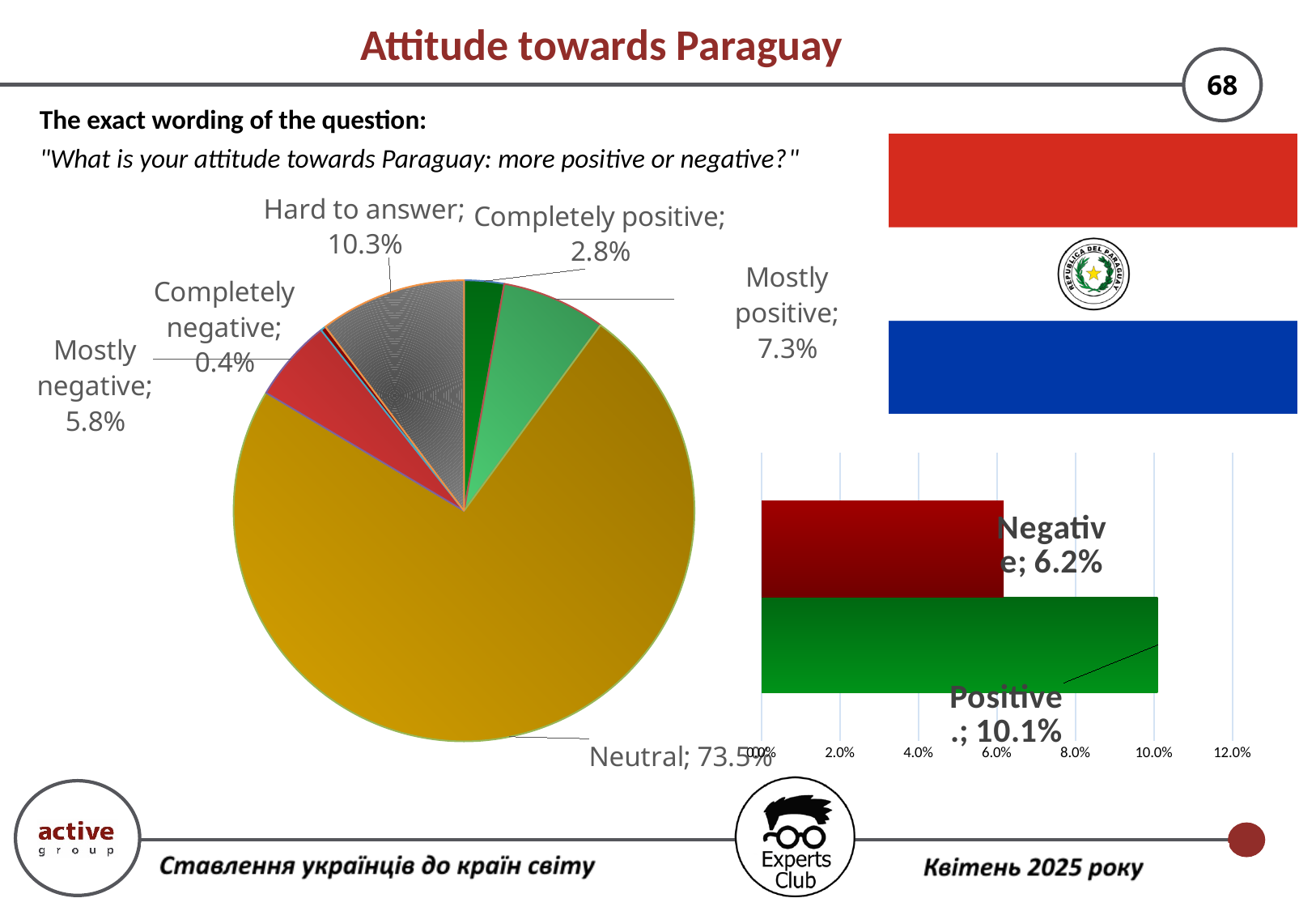
In the pie chart, which category has the largest slice? Neutral In the bar chart on the right, what is the difference between "Positive" and "Negative"? 3.9% In the pie chart, what is the difference between "Mostly positive" and "Completely positive"? 4.5% In the pie chart, which category has the smallest slice? Completely negative How many categories does the pie chart show? 6 In the pie chart, which is larger: "Mostly negative" or "Mostly positive"? Mostly positive What kind of chart is shown on the right side of the slide below the flag? Bar chart In the pie chart, what is the value for "Completely negative"? 0.4% In the pie chart, what is the value for "Mostly positive"? 7.3% In the bar chart on the right, what is the value for "Positive"? 10.1% In the pie chart, what share of respondents answered "Neutral"? 73.5% In the pie chart, what is the value for "Hard to answer"? 10.3%